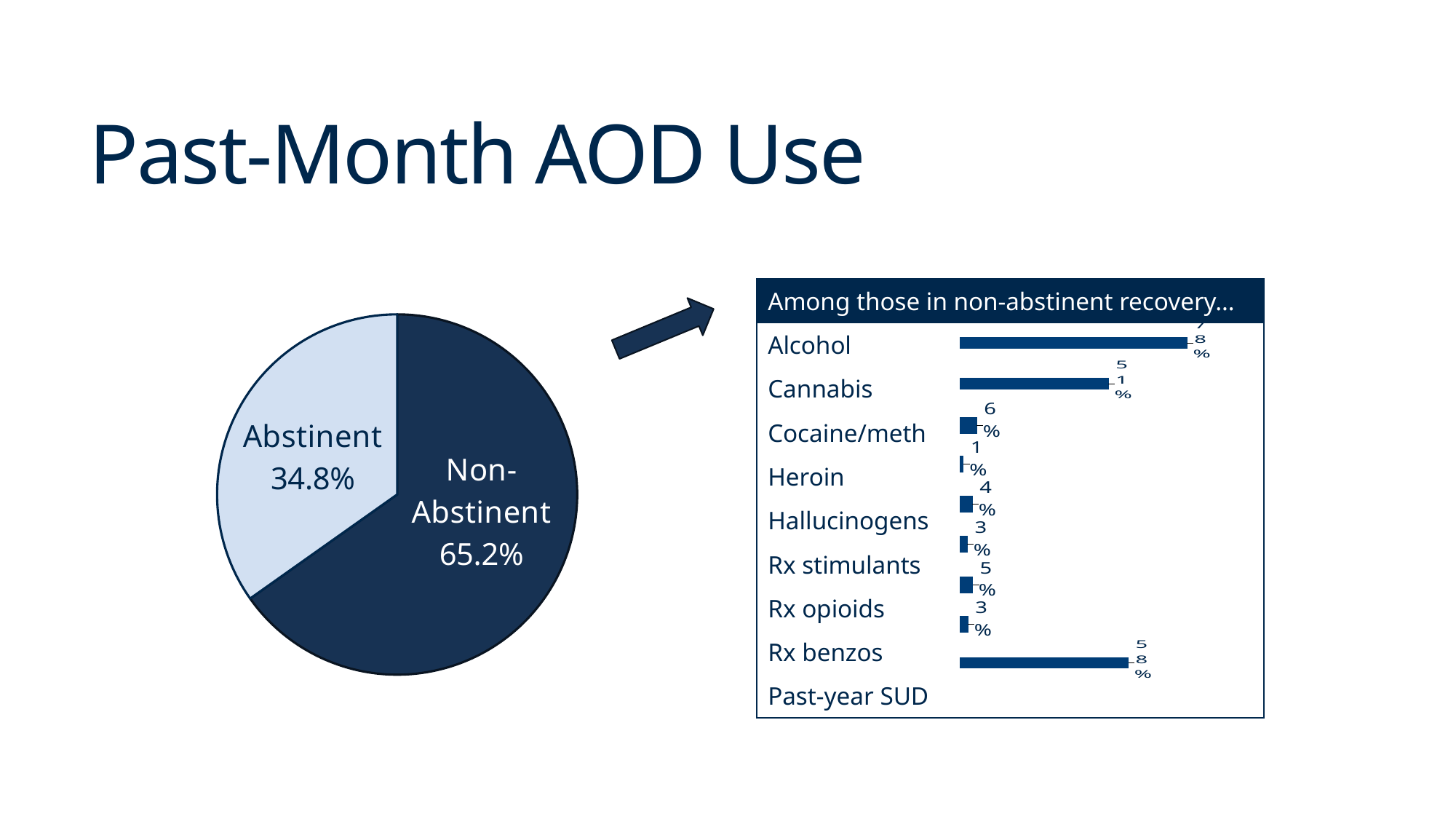
In the pie chart, which slice is larger, Abstinent or Non-Abstinent? Non-Abstinent How many slices does the pie chart have? 2 How many categories are shown in the 'Among those in non-abstinent recovery...' chart? 9 In the 'Among those in non-abstinent recovery...' chart, which category has the highest value? Alcohol In the pie chart, what percentage is Non-Abstinent? 65.2% In the 'Among those in non-abstinent recovery...' chart, what is the value for Past-year SUD? 58% What kind of chart is the 'Among those in non-abstinent recovery...' chart? Bar chart In the pie chart, what is the difference between the Non-Abstinent and Abstinent shares? 30.4% In the pie chart, what percentage is Abstinent? 34.8% What kind of chart is on the left of the slide? Pie chart In the 'Among those in non-abstinent recovery...' chart, what is the value for Cannabis? 51% In the 'Among those in non-abstinent recovery...' chart, what is the value for Heroin? 1%